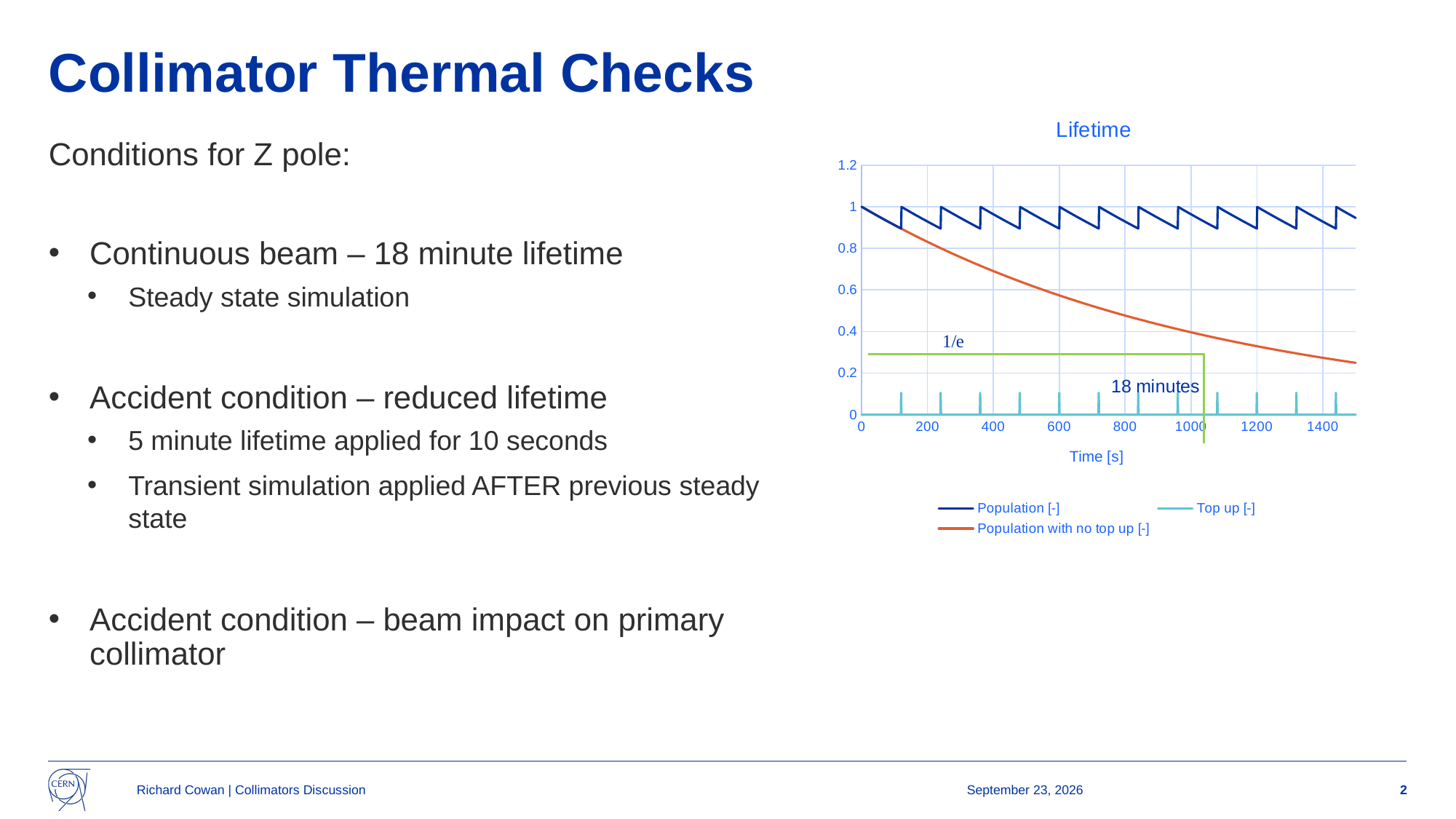
What is the value of 'Population [-]' at time 0 s? 1 What kind of chart is shown on the slide? line chart Is the value of 'Population with no top up [-]' at 1400 s greater or less than 0.4? less At 1400 s, which is larger: 'Population [-]' or 'Population with no top up [-]'? Population [-] What is the label of the x axis of the Lifetime chart? Time [s] Which series has the lowest value at 1400 s? Top up [-] Is the value of 'Population [-]' at 1400 s greater or less than 0.8? greater What is the title of the chart? Lifetime Is the value of 'Population with no top up [-]' at 1400 s greater or less than 0.2? greater Does the 'Population with no top up [-]' series rise or fall as time increases? fall How many 'Top up [-]' spikes are plotted on the chart? 12 How many series does the legend of the Lifetime chart list? 3